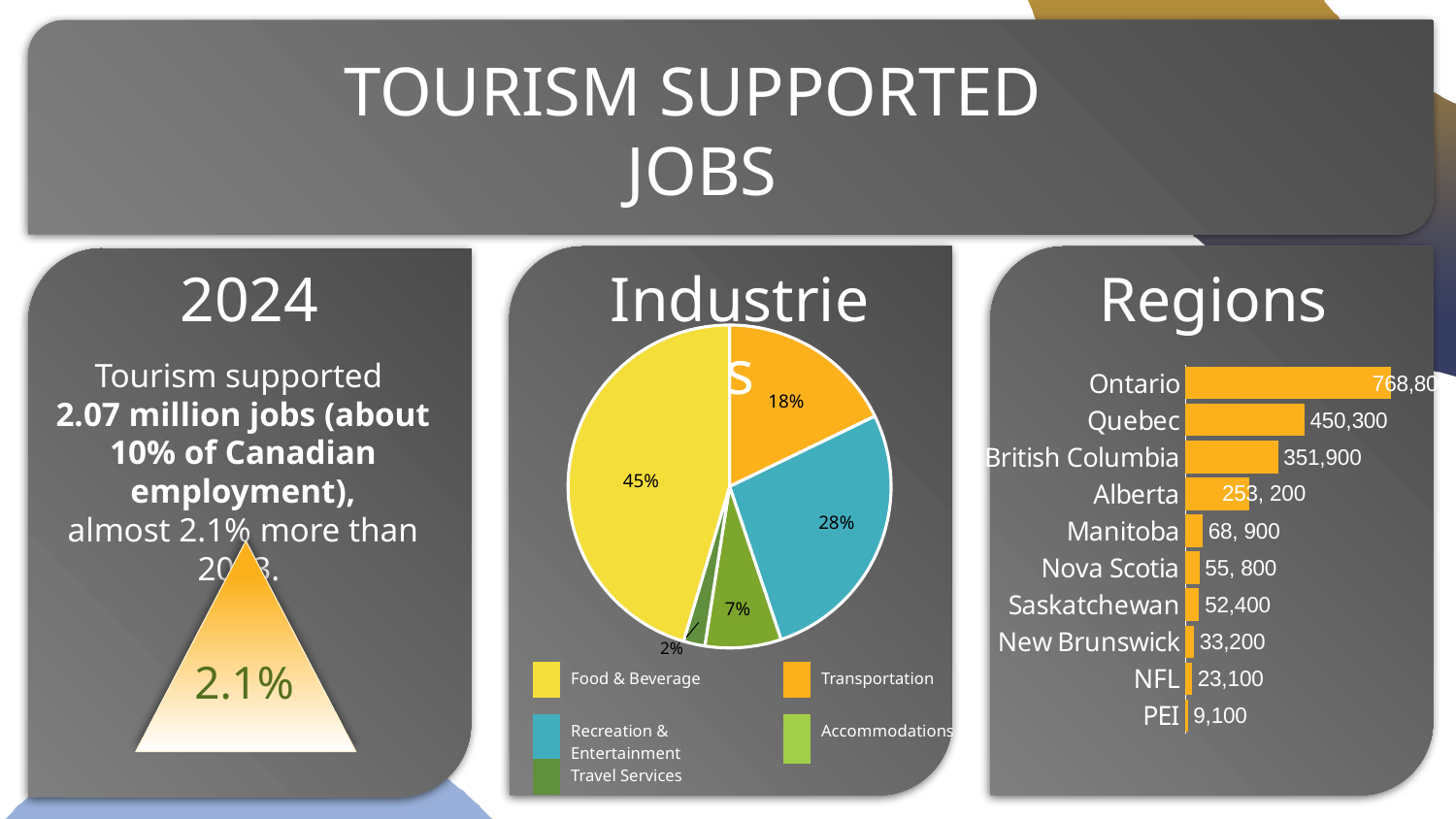
In the Regions chart, which region has the highest value? Ontario In the Industries pie chart, how many industries does the legend list? 5 In the Regions chart, what is the value for Quebec? 450,300 In the Industries pie chart, what percentage is shown for Recreation & Entertainment? 28% In the Regions chart, what is the value for British Columbia? 351,900 In the Industries pie chart, which industry has the largest slice? Food & Beverage In the Regions chart, what is the value for PEI? 9,100 What kind of chart is the Regions chart? Bar chart In the Industries pie chart, what percentage is shown for Transportation? 18% In the Industries pie chart, which industry has the smallest slice? Travel Services In the Industries pie chart, what share of jobs is Food & Beverage? 45% In the Regions chart, what is the difference between Quebec and British Columbia? 98,400